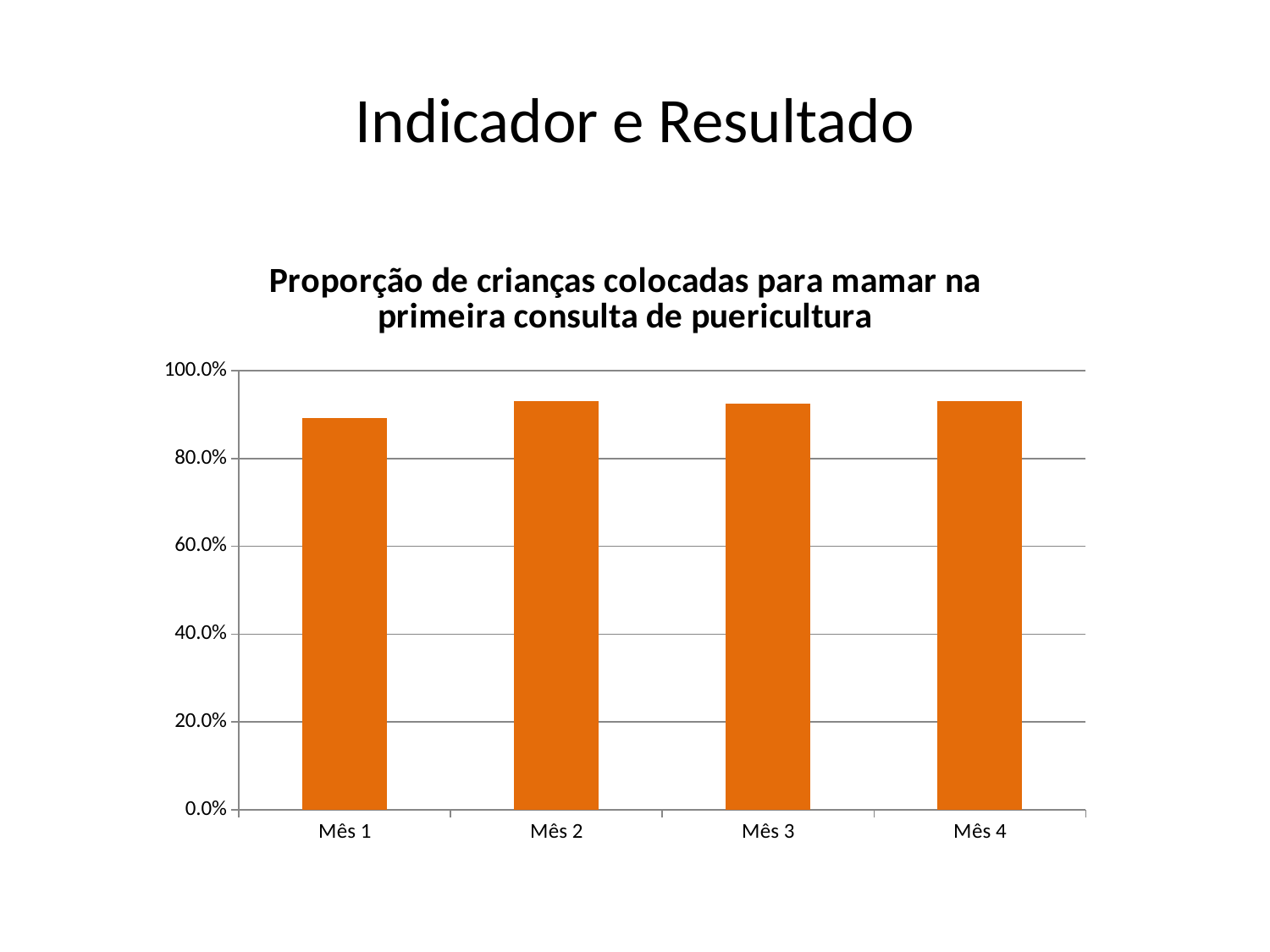
Which month has the lowest value on the chart? Mês 1 Which is larger, the value for Mês 1 or the value for Mês 2? Mês 2 Does the value rise or fall from Mês 1 to Mês 2? rise Which is larger, the value for Mês 1 or the value for Mês 4? Mês 4 What kind of chart is shown on the slide? bar chart Is the value for Mês 2 greater or less than 100.0%? less What colour are the bars in the chart? orange How many categories (months) are plotted on the chart? 4 Is the value for Mês 1 greater or less than 80.0%? greater Is the value for Mês 4 greater or less than 60.0%? greater What is the title of the chart? Proporção de crianças colocadas para mamar na primeira consulta de puericultura